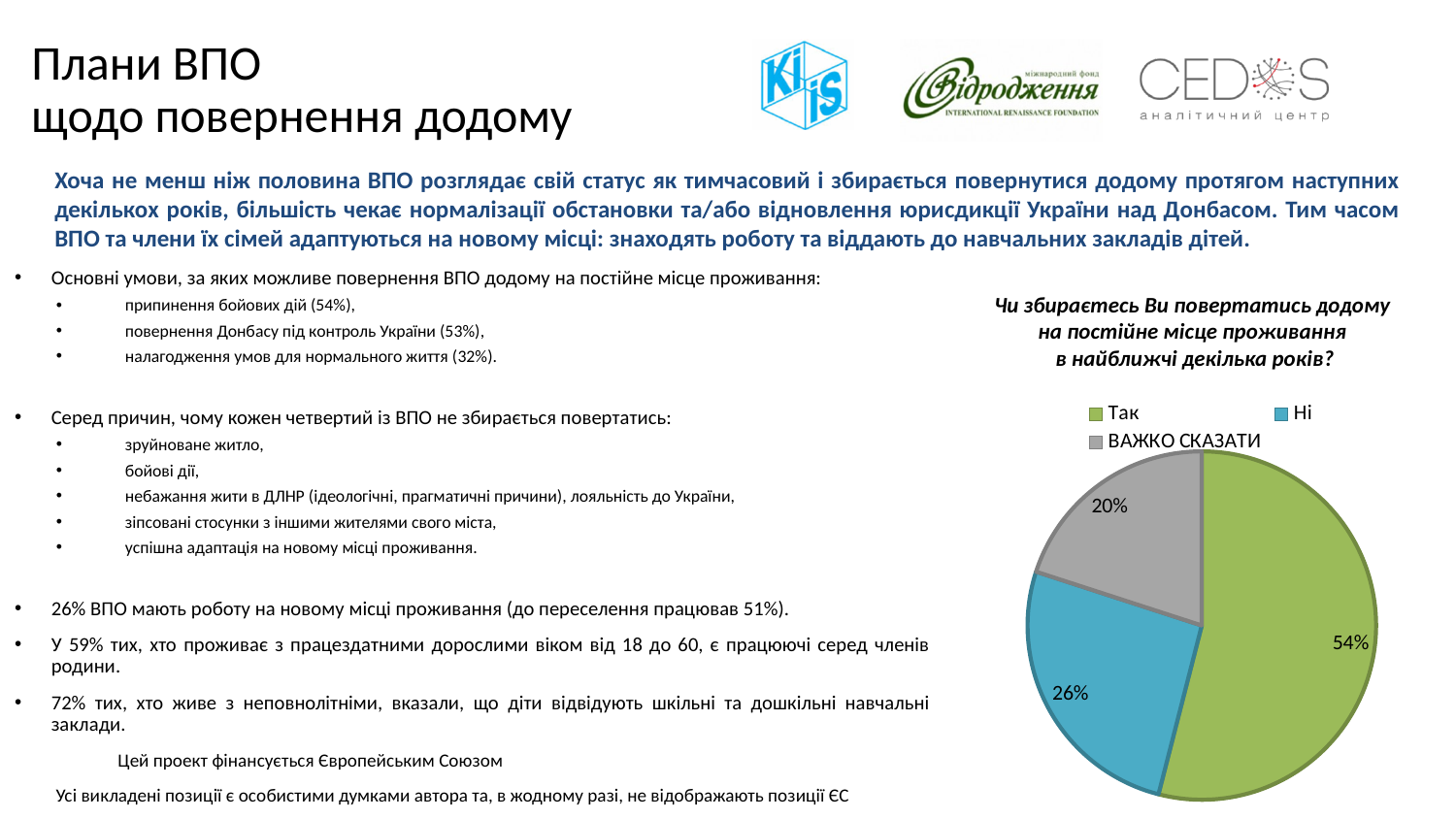
What type of chart is shown on the slide? pie chart How many entries does the pie chart legend list? 3 Which category has the largest slice in the pie chart? Так Which category has the smallest slice in the pie chart? ВАЖКО СКАЗАТИ What share of the pie chart corresponds to "Ні"? 26% What colour is the "Так" slice in the pie chart? green What is the title of the pie chart? Чи збираєтесь Ви повертатись додому на постійне місце проживання в найближчі декілька років? What share of the pie chart corresponds to "Так"? 54% What share of the pie chart corresponds to "ВАЖКО СКАЗАТИ"? 20% How many slices does the pie chart have? 3 Which slice is larger, "Ні" or "ВАЖКО СКАЗАТИ"? Ні What is the difference in percentage points between the "Так" and "Ні" slices? 28